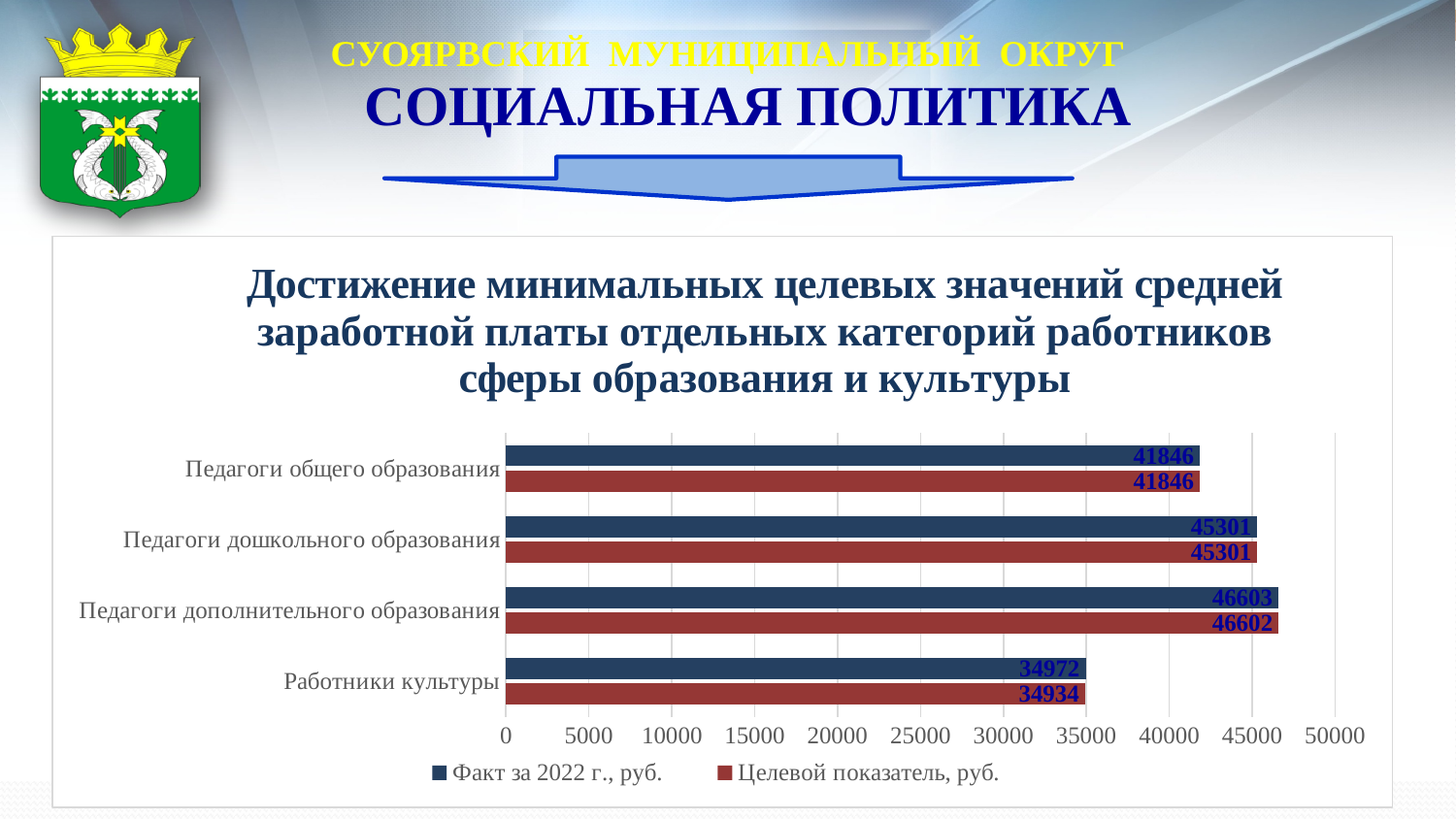
What is the value of "Целевой показатель, руб." for Педагоги дошкольного образования? 45301 How many categories are shown on the chart? 4 What is the value of "Факт за 2022 г., руб." for Педагоги дополнительного образования? 46603 What is the difference between "Факт за 2022 г., руб." and "Целевой показатель, руб." for Работники культуры? 38 Which category has the lowest value for "Целевой показатель, руб."? Работники культуры What is the value of "Целевой показатель, руб." for Работники культуры? 34934 What is the value of "Факт за 2022 г., руб." for Педагоги общего образования? 41846 What type of chart is shown on the slide? bar chart How many series does the legend list? 2 Which is larger for Педагоги дополнительного образования: "Факт за 2022 г., руб." or "Целевой показатель, руб."? Факт за 2022 г., руб. Which category has the highest value for "Факт за 2022 г., руб."? Педагоги дополнительного образования Is the value of "Факт за 2022 г., руб." for Работники культуры greater or less than 40000? less